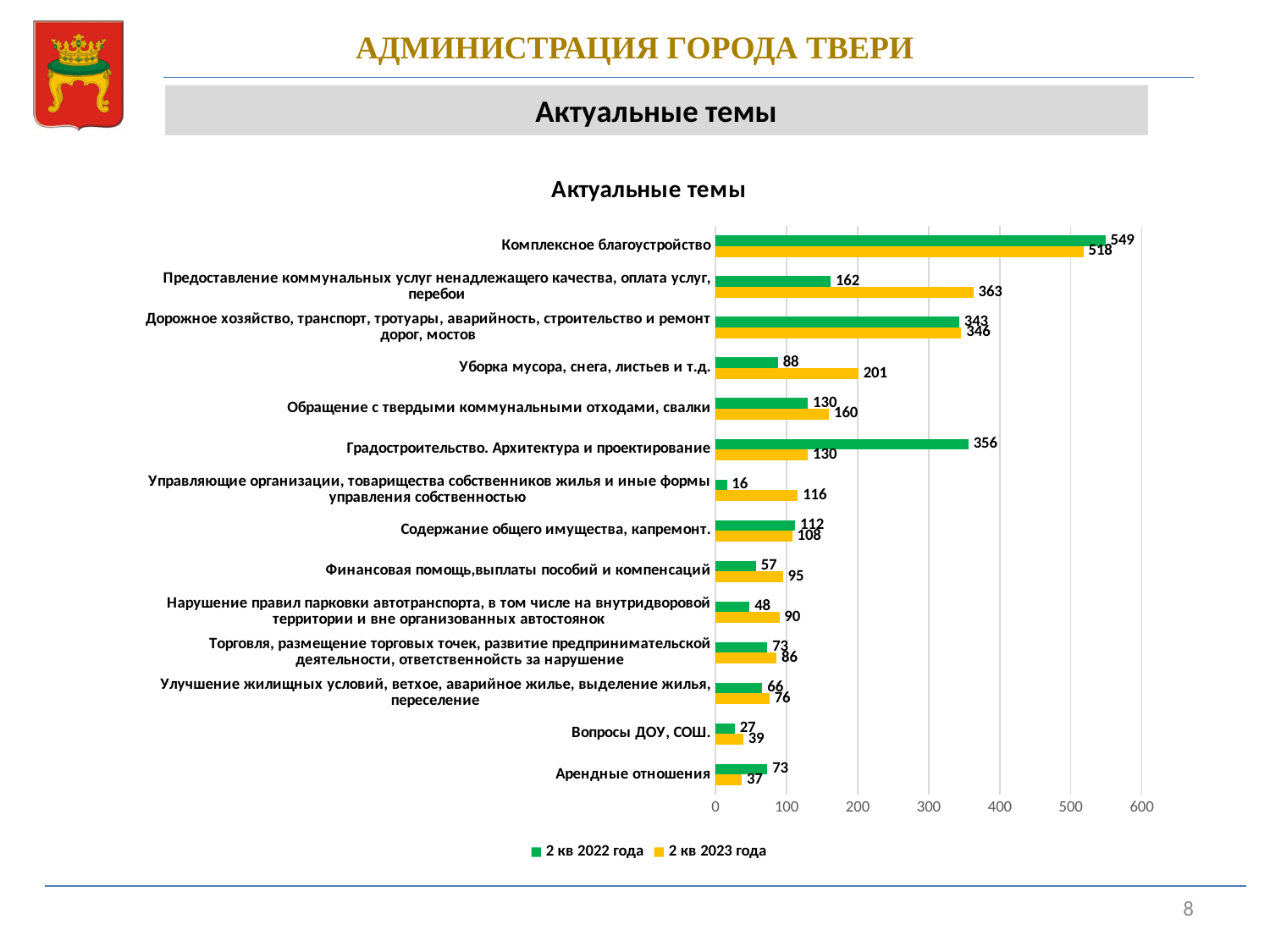
What is the value for «Градостроительство. Архитектура и проектирование» in the «2 кв 2022 года» series? 356 What is the title of the chart? Актуальные темы For «Арендные отношения», which series has the larger value: «2 кв 2022 года» or «2 кв 2023 года»? 2 кв 2022 года How many categories are shown on the chart? 14 Is the «2 кв 2022 года» value for «Дорожное хозяйство, транспорт, тротуары, аварийность, строительство и ремонт дорог, мостов» greater or less than 300? greater What is the difference between the «2 кв 2023 года» and «2 кв 2022 года» values for «Предоставление коммунальных услуг ненадлежащего качества, оплата услуг, перебои»? 201 How many series does the legend list? 2 What kind of chart is shown on the slide? Bar chart What is the value for «Уборка мусора, снега, листьев и т.д.» in the «2 кв 2023 года» series? 201 Which category has the highest value in the «2 кв 2023 года» series? Комплексное благоустройство What is the value for «Комплексное благоустройство» in the «2 кв 2022 года» series? 549 Which category has the lowest value in the «2 кв 2022 года» series? Управляющие организации, товарищества собственников жилья и иные формы управления собственностью